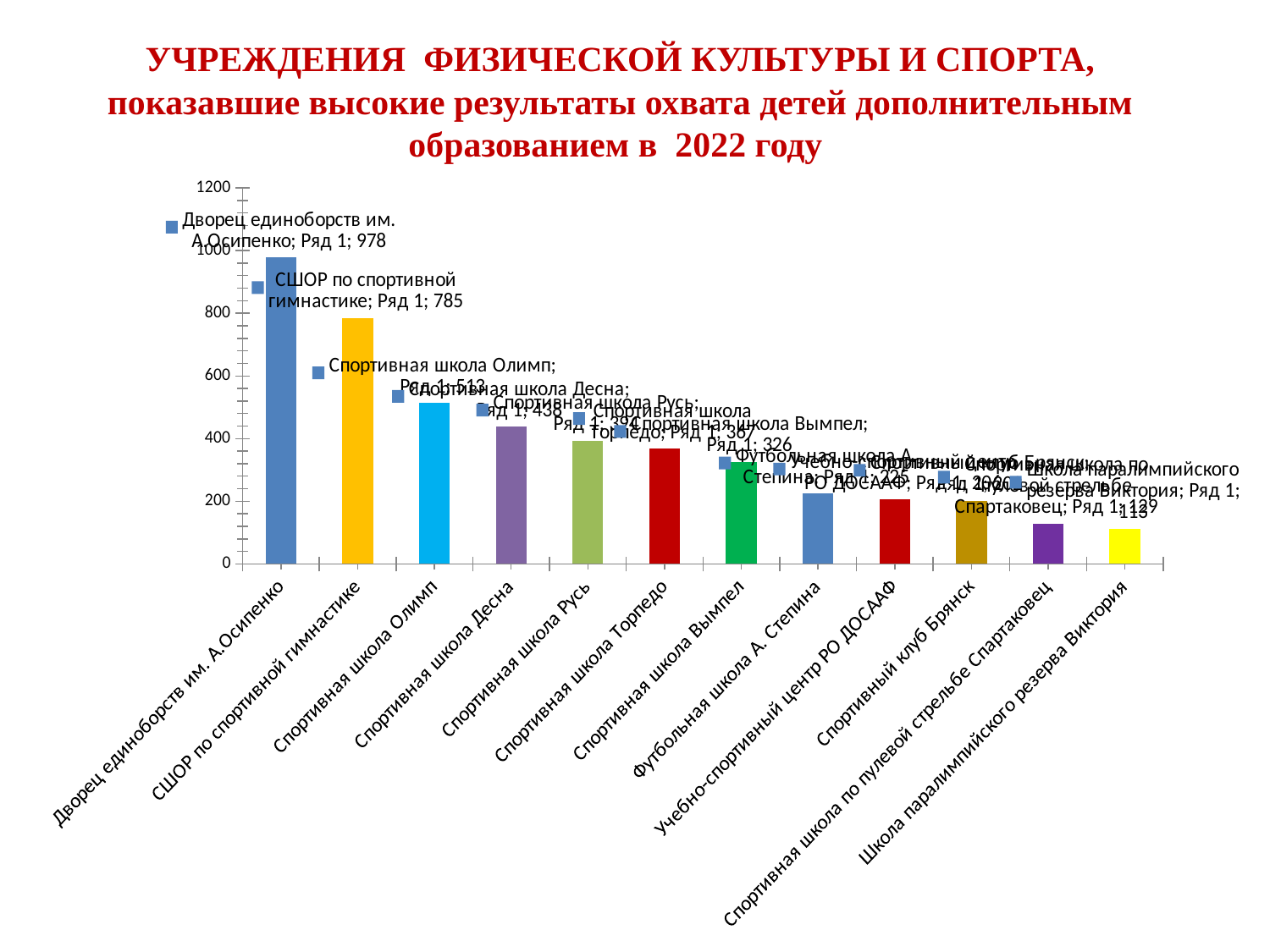
Which institution has the lowest value? Школа паралимпийского резерва Виктория What is the value for Спортивная школа по пулевой стрельбе Спартаковец? 129 What is the value for Дворец единоборств им. А.Осипенко? 978 What is the value for СШОР по спортивной гимнастике? 785 What kind of chart is shown on the slide? bar chart Which institution has the highest value? Дворец единоборств им. А.Осипенко What is the value for Спортивная школа Вымпел? 326 Which is larger, the value for Спортивная школа Десна or Спортивная школа Русь? Спортивная школа Десна Is the value for Спортивный клуб Брянск greater or less than 400? less What is the difference between the values for Дворец единоборств им. А.Осипенко and СШОР по спортивной гимнастике? 193 How many institutions are shown in the chart? 12 What is the difference between the values for Спортивная школа Торпедо and Спортивная школа Вымпел? 41